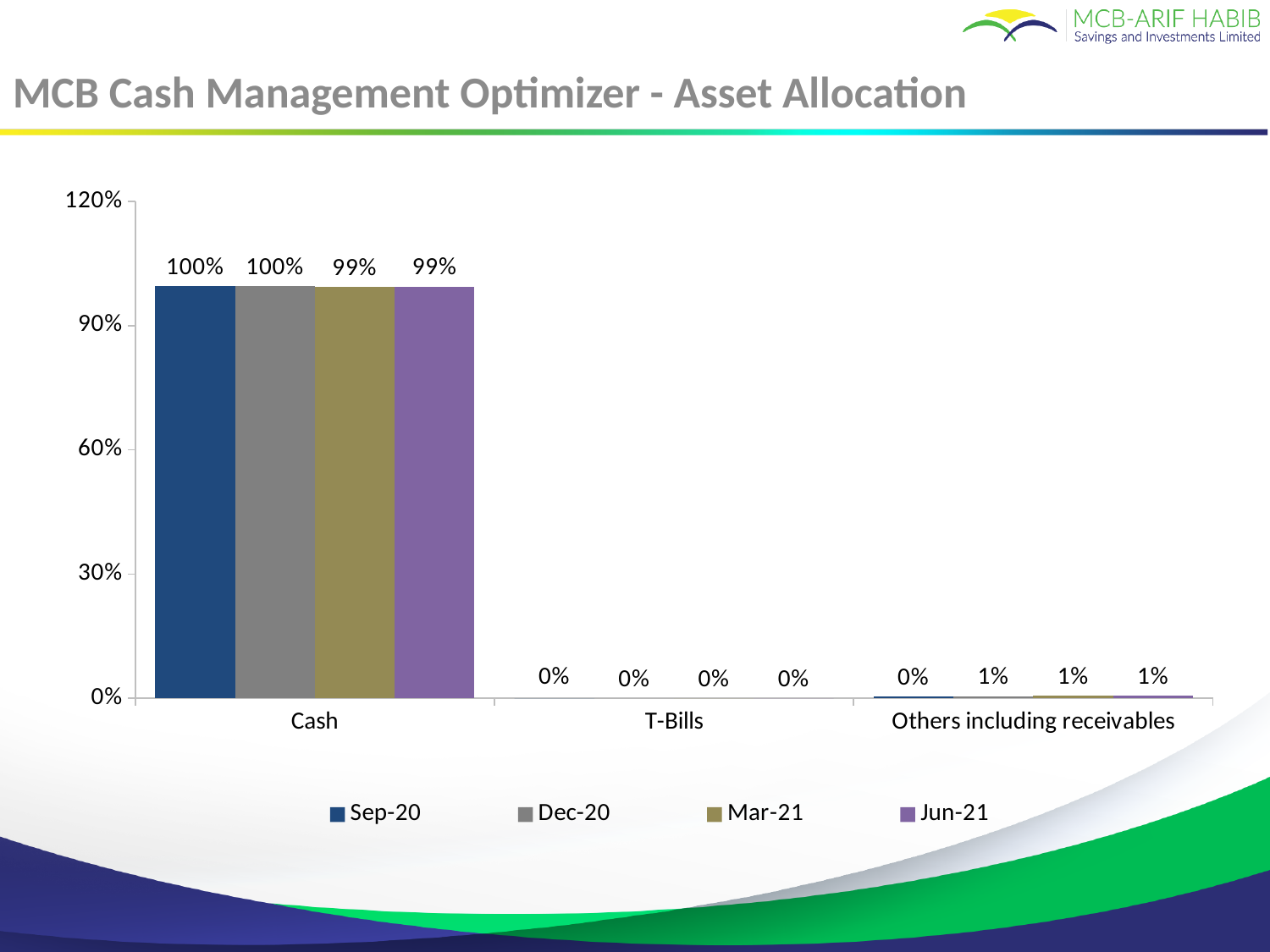
What is the value for T-Bills in Dec-20? 0% How many series does the legend list? 4 Is the value for Cash in Mar-21 greater or less than 90%? greater Which category has the highest value for Jun-21? Cash What is the value for Cash in Sep-20? 100% What is the value for Others including receivables in Sep-20? 0% What is the value for Cash in Jun-21? 99% What is the difference between the Cash value in Sep-20 and the Cash value in Mar-21? 1% How many categories are shown on the x axis? 3 What is the value for Others including receivables in Mar-21? 1% Which is larger: the Cash value in Dec-20 or the Cash value in Jun-21? Cash in Dec-20 What kind of chart is shown on the slide? bar chart